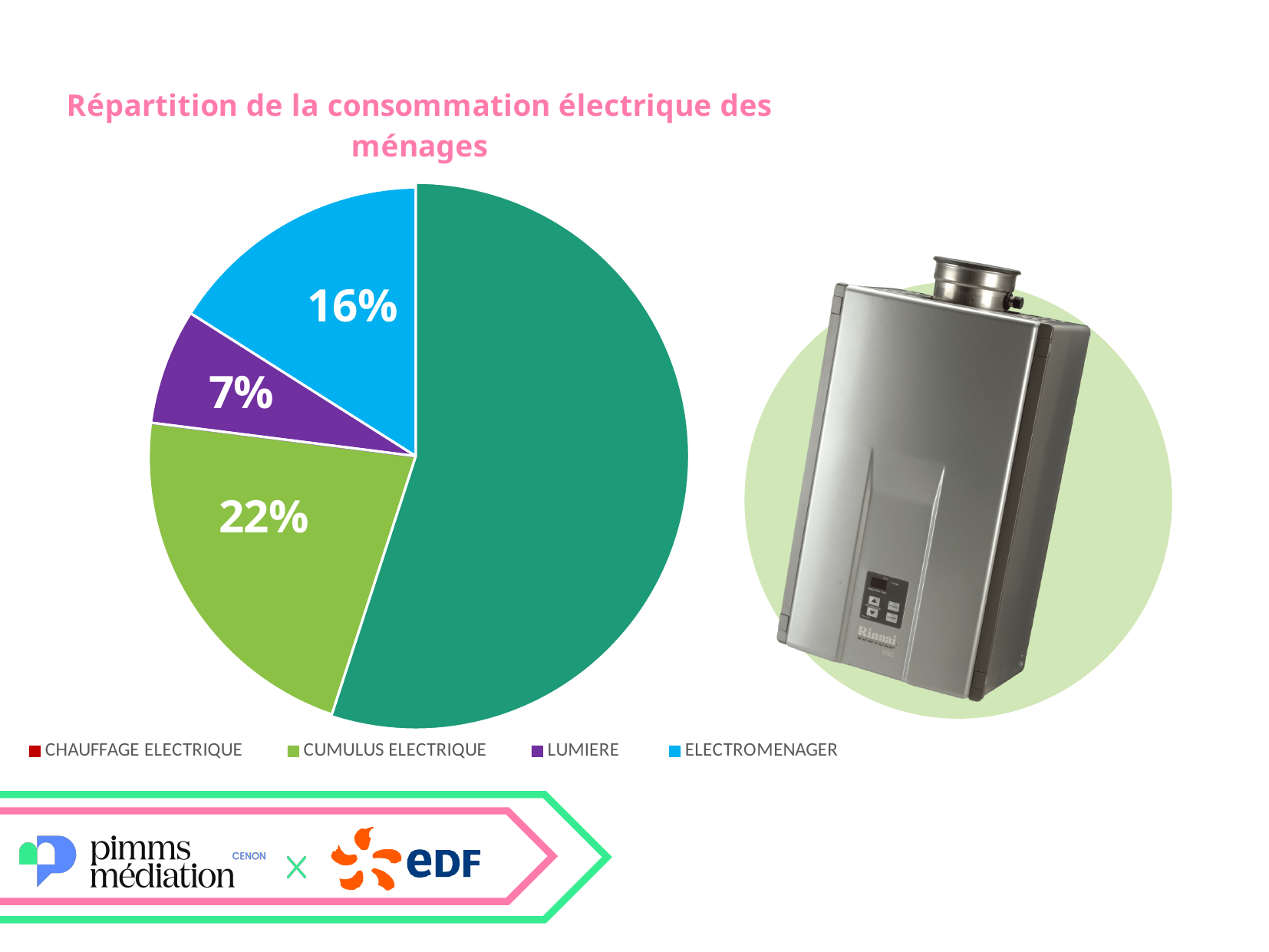
Which category has the largest slice of the pie? CHAUFFAGE ELECTRIQUE Which category has the smallest slice of the pie? LUMIERE What is the difference in percentage points between ELECTROMENAGER and LUMIERE? 9% Which is larger, the slice for CUMULUS ELECTRIQUE or the slice for ELECTROMENAGER? CUMULUS ELECTRIQUE What share of the pie does LUMIERE represent? 7% What is the difference in percentage points between CUMULUS ELECTRIQUE and ELECTROMENAGER? 6% What is the title of the chart? Répartition de la consommation électrique des ménages How many categories does the pie chart have? 4 What percentage is shown for ELECTROMENAGER? 16% What percentage is shown for LUMIERE? 7% What kind of chart is shown on the slide? pie chart What percentage is shown for CUMULUS ELECTRIQUE? 22%